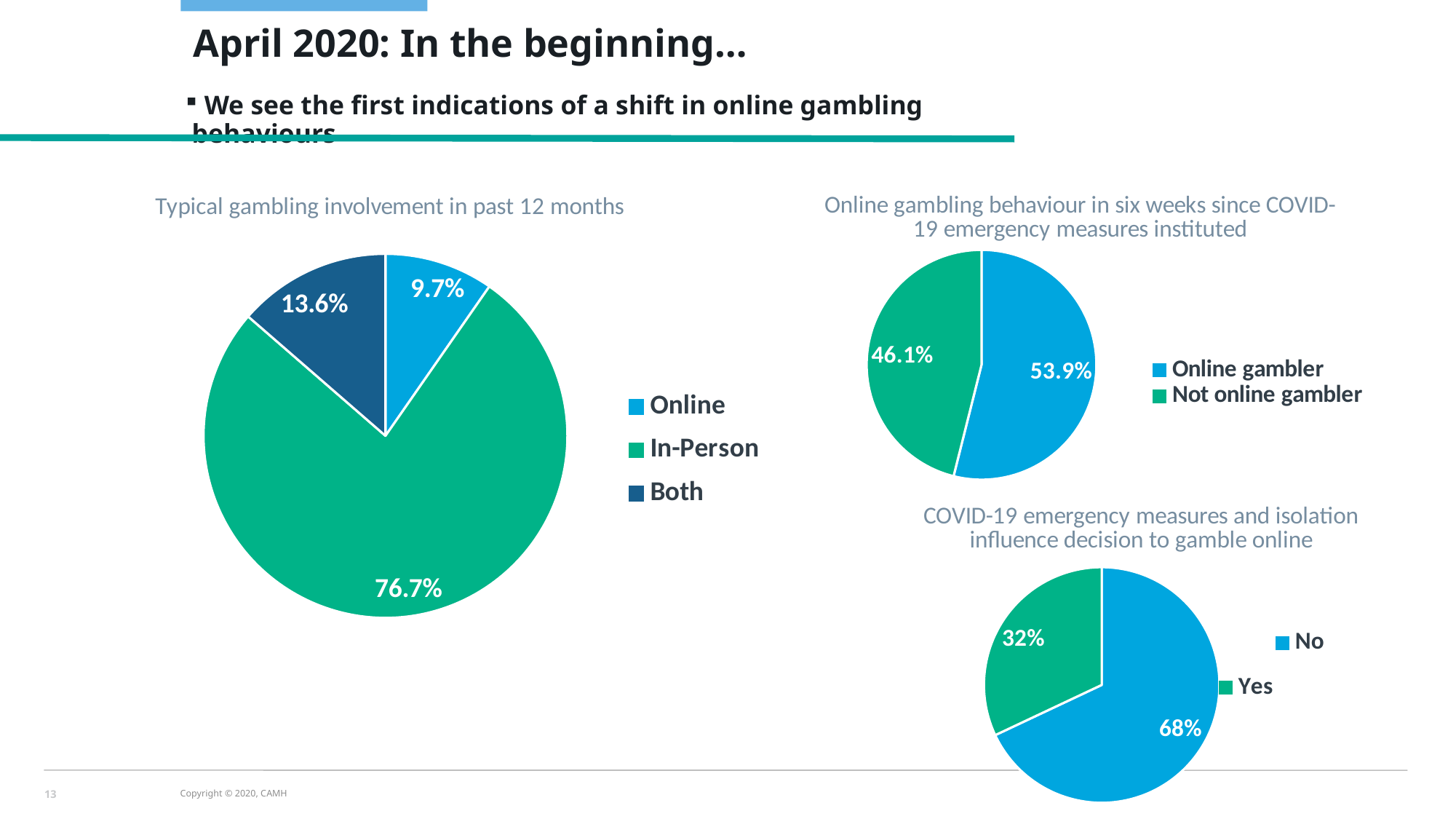
In the 'Online gambling behaviour in six weeks since COVID-19 emergency measures instituted' chart, which is larger, Online gambler or Not online gambler? Online gambler In the 'COVID-19 emergency measures and isolation influence decision to gamble online' chart, which answer has the largest slice? No In the 'Typical gambling involvement in past 12 months' chart, which category has the smallest slice? Online How many slices does the 'Typical gambling involvement in past 12 months' chart have? 3 In the 'Online gambling behaviour in six weeks since COVID-19 emergency measures instituted' chart, what share is Online gambler? 53.9% In the 'Typical gambling involvement in past 12 months' chart, what is the difference between the Both and Online shares? 3.9% In the 'Typical gambling involvement in past 12 months' chart, what share is Online? 9.7% In the 'COVID-19 emergency measures and isolation influence decision to gamble online' chart, what share answered Yes? 32% In the 'Online gambling behaviour in six weeks since COVID-19 emergency measures instituted' chart, what is the difference between Online gambler and Not online gambler? 7.8% In the 'Typical gambling involvement in past 12 months' chart, what share is In-Person? 76.7% What type of chart is used for 'COVID-19 emergency measures and isolation influence decision to gamble online'? Pie chart How many entries does the legend of the 'Typical gambling involvement in past 12 months' chart list? 3